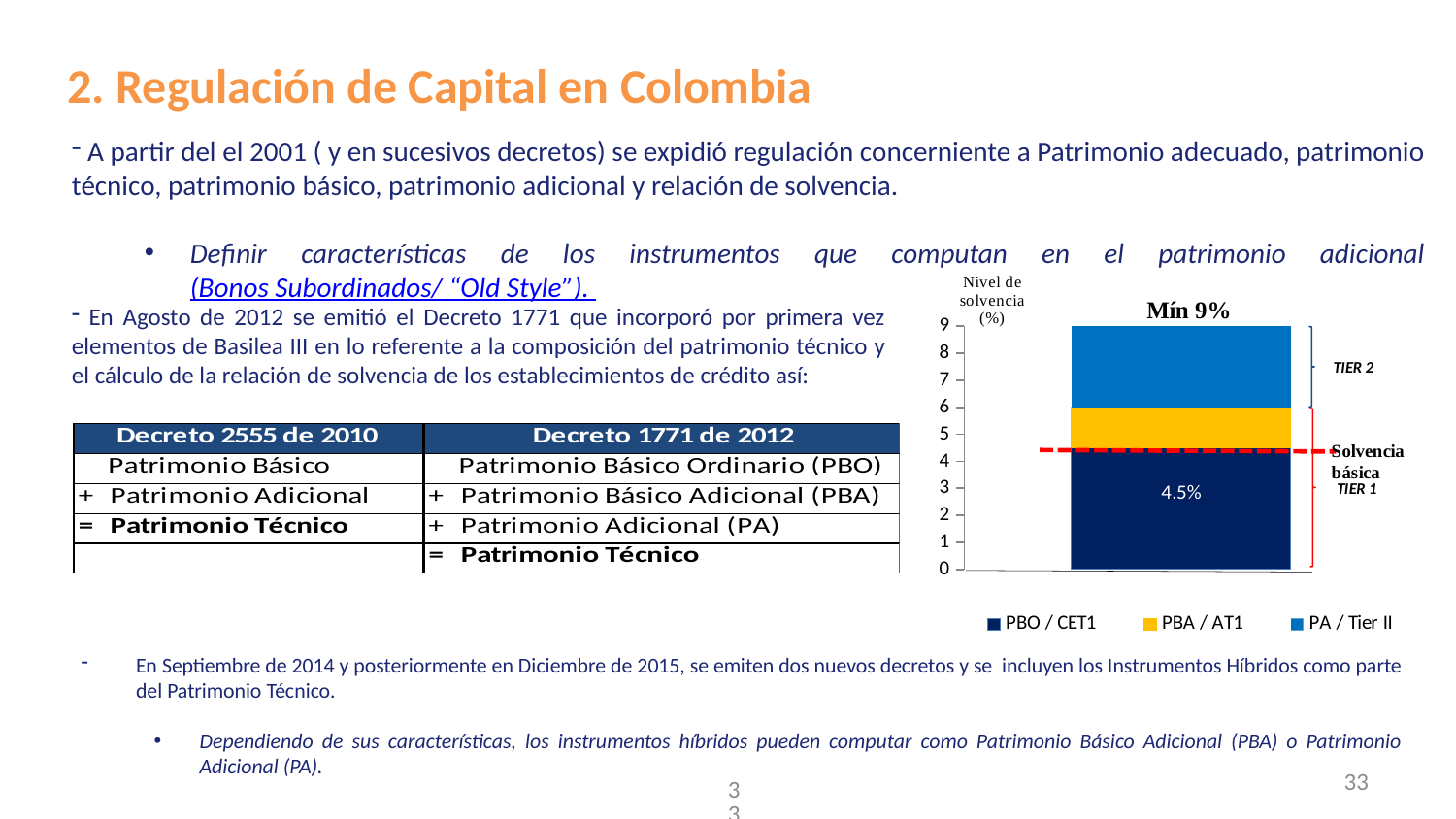
Which series has the smallest segment in the stacked bar? PBA / AT1 How many bars are plotted in the chart? 1 What is the title shown above the chart? Mín 9% Which series has the largest segment in the stacked bar? PBO / CET1 What value is labelled on the PBO / CET1 segment of the bar? 4.5% What are the three entries in the chart legend? PBO / CET1, PBA / AT1, PA / Tier II Which segment is larger, PBO / CET1 or PA / Tier II? PBO / CET1 Is the value for PBO / CET1 greater or less than 4? greater What value on the y axis does the top of the stacked bar reach? 9 How many series does the chart legend list? 3 What kind of chart is shown on the slide? bar chart Is the value for PBO / CET1 greater or less than 5? less